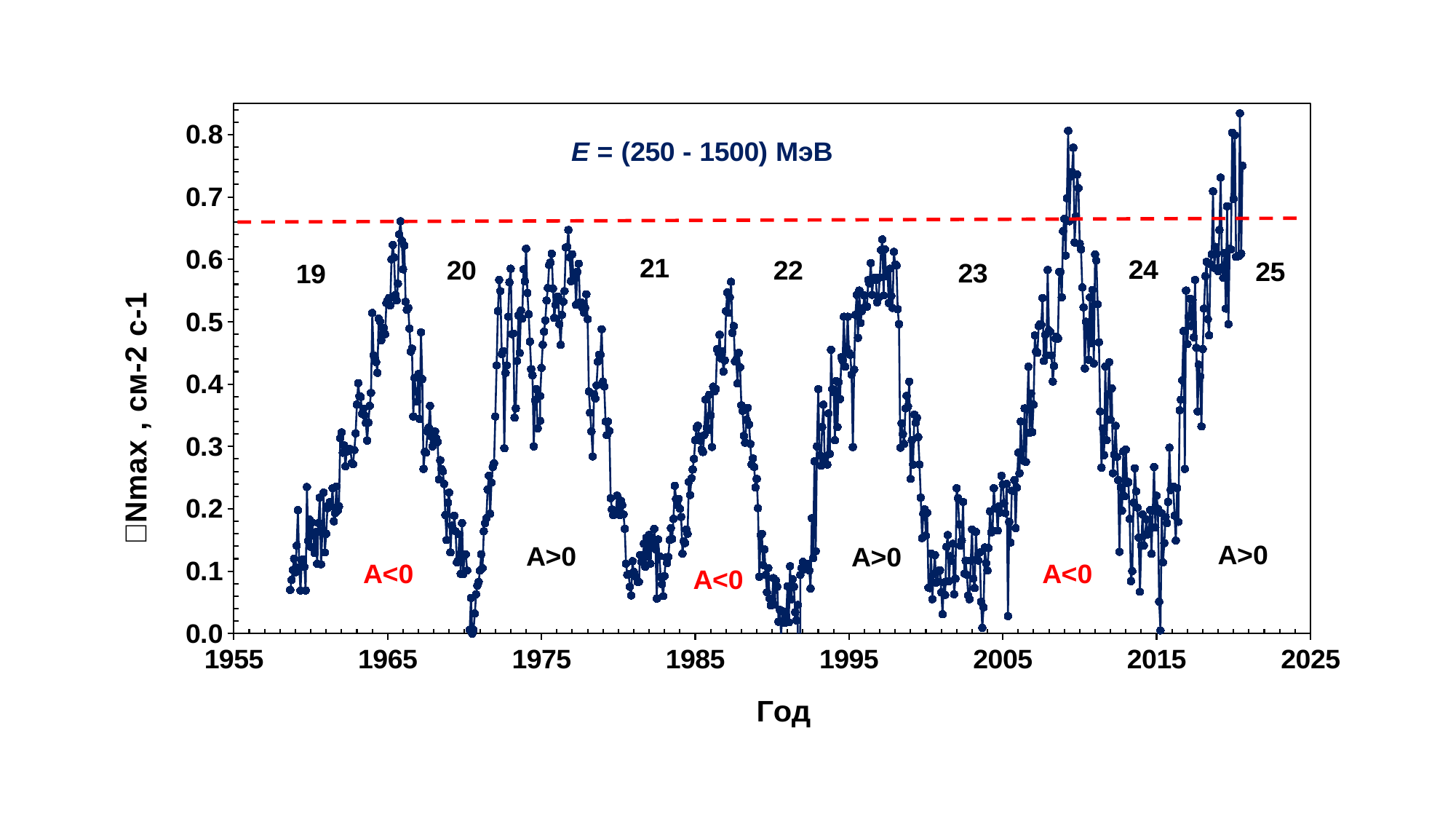
What is the label of the x axis? Год What energy range is stated in the annotation at the top of the chart? E = (250 - 1500) МэВ Between which two y-axis tick values does the red dashed horizontal line lie? 0.6 and 0.7 How many numbered solar cycles are labeled on the chart? 7 Is the value around 1990 greater or less than 0.1? less Which cycle number is labeled furthest to the right on the chart? 25 Is the highest value reached around 2020 greater or less than 0.8? greater Do the values rise or fall from 1958 to 1966? rise How many times does the label 'A<0' appear on the chart? 3 What kind of chart is shown on the slide? line chart